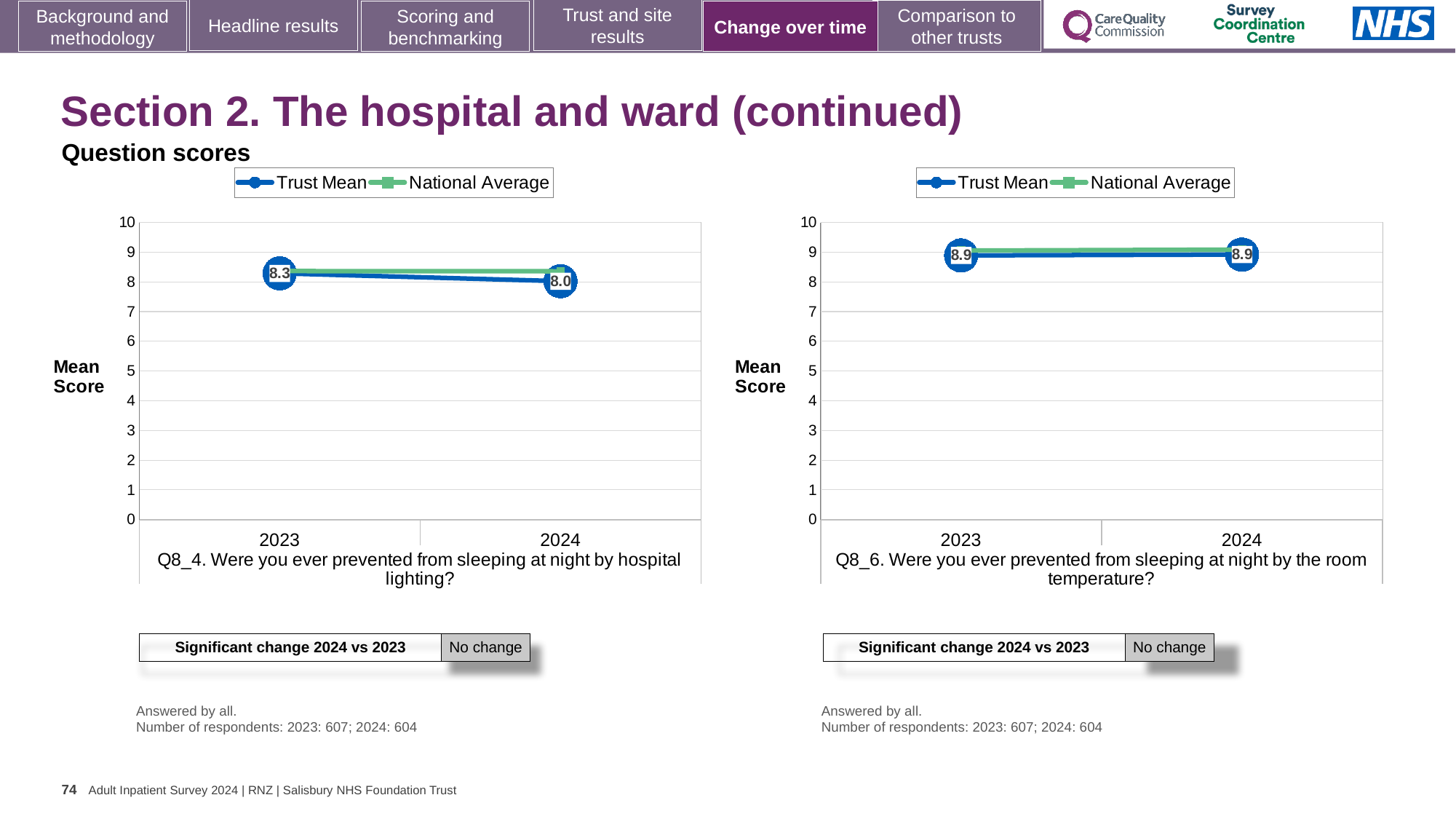
In the Q8_4 chart (left), what is the Trust Mean for 2024? 8.0 In the Q8_4 chart (left), by how much did the Trust Mean change from 2023 to 2024? 0.3 How many years are plotted on the x axis of the Q8_4 chart (left)? 2 In the Q8_6 chart (right), what is the Trust Mean for 2023? 8.9 How many series does the legend of the Q8_6 chart (right) list? 2 In the Q8_6 chart (right), is the National Average for 2024 greater or less than 8? greater What are the two series named in the legend of the Q8_4 chart (left)? Trust Mean and National Average In the Q8_4 chart (left), which year has the higher Trust Mean, 2023 or 2024? 2023 What kind of chart is the Q8_6 chart (right)? line chart In the Q8_4 chart (left), what is the Trust Mean for 2023? 8.3 In the Q8_4 chart (left), does the Trust Mean rise or fall from 2023 to 2024? fall In the Q8_6 chart (right), what is the Trust Mean for 2024? 8.9